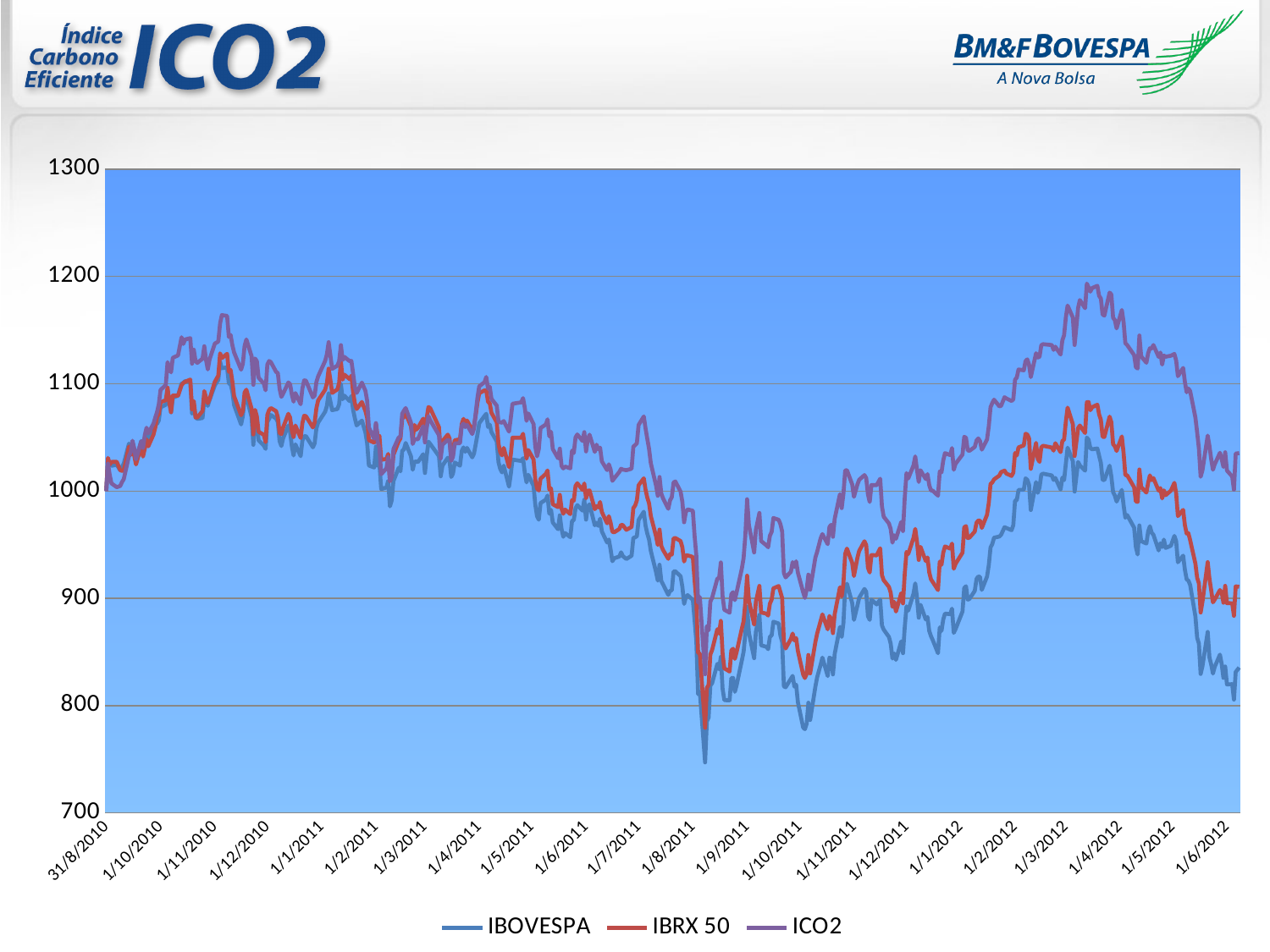
Which series reaches the lowest value on the chart? IBOVESPA At 1/3/2012, which is higher, ICO2 or IBOVESPA? ICO2 What kind of chart is shown on the slide? line chart Is the lowest value of IBOVESPA around 1/8/2011 greater or less than 800? less Which series reaches the highest value on the chart? ICO2 Which series are listed in the legend? IBOVESPA, IBRX 50, ICO2 Is the value of IBOVESPA at 1/6/2012 greater or less than 900? less Does the ICO2 line rise or fall between 1/10/2011 and 1/3/2012? rise Does the IBOVESPA line rise or fall between 1/4/2012 and 1/6/2012? fall What colour is the ICO2 line? purple Is the peak value of ICO2 around 1/3/2012 greater or less than 1100? greater How many series does the legend list? 3